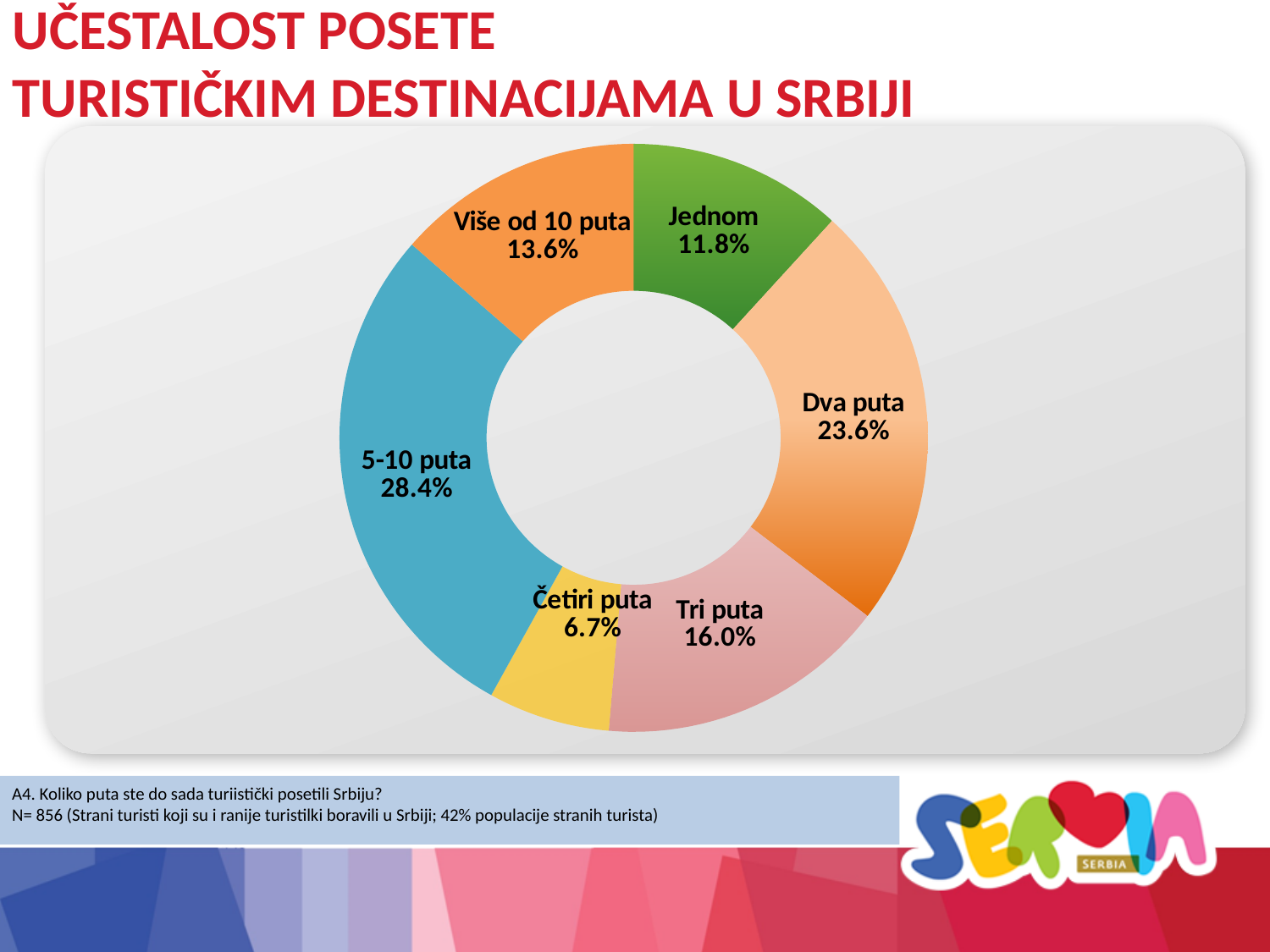
What is the value for the 'Dva puta' slice? 23.6% How many categories are shown in the chart? 6 What kind of chart is shown on the slide? Doughnut (pie) chart What is the value for 'Četiri puta'? 6.7% What share is shown for '5-10 puta'? 28.4% What is the difference between the shares for '5-10 puta' and 'Dva puta'? 4.8% What percentage is shown for 'Tri puta'? 16.0% Which is larger, the share for 'Tri puta' or for 'Više od 10 puta'? Tri puta What share of respondents visited Serbia 'Jednom' (once)? 11.8% Which category has the smallest share of the chart? Četiri puta What percentage is shown for 'Više od 10 puta'? 13.6% Which category has the largest share of the chart? 5-10 puta